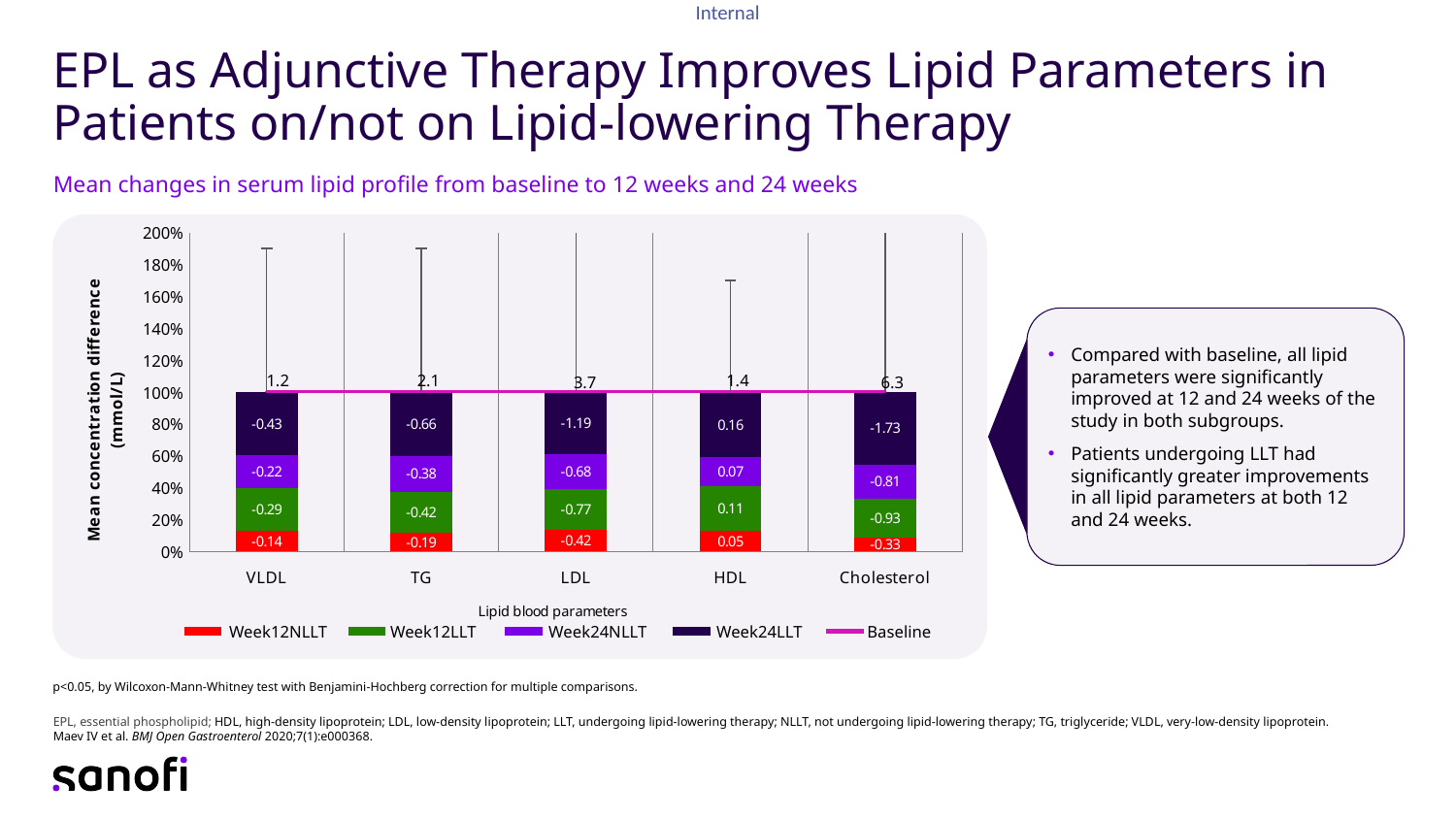
What is the Week12NLLT value for LDL? -0.42 What is the Week24LLT value for Cholesterol? -1.73 Which lipid parameter has the lowest labelled baseline value? VLDL How many series does the chart legend list? 5 How many lipid blood parameters are shown on the x axis of the chart? 5 For HDL, which is larger: the Week12LLT value or the Week12NLLT value? Week12LLT What is the Week24NLLT value for TG? -0.38 What baseline value is labelled for Cholesterol? 6.3 Which lipid parameter has the highest labelled baseline value? Cholesterol What is the difference between the Week12LLT value (0.11) and the Week12NLLT value (0.05) for HDL? 0.06 What kind of chart is shown on the slide? Stacked bar chart with a line (combination bar and line chart) What is the Week12LLT value for HDL? 0.11